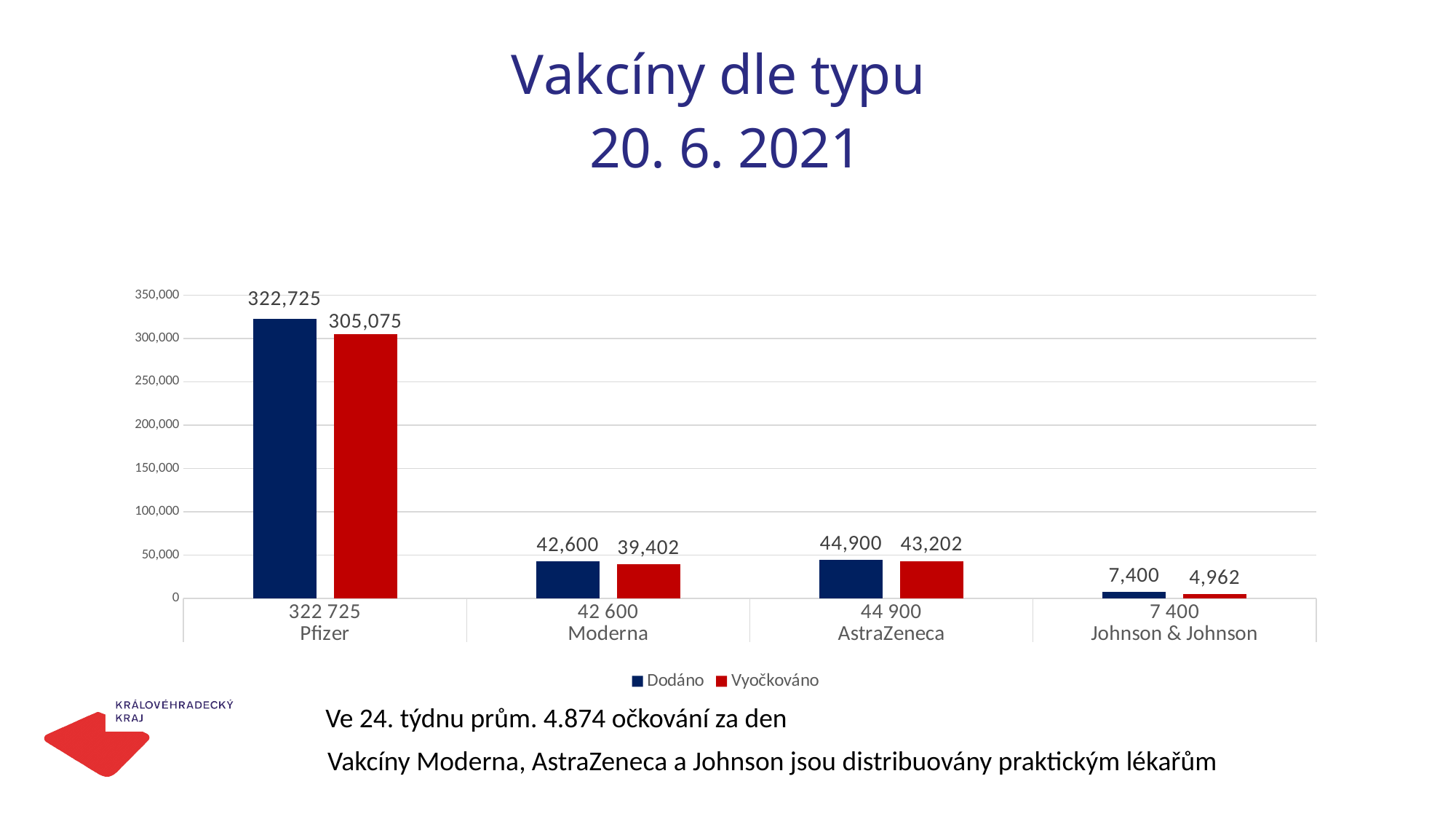
Which vaccine has the lowest Vyočkováno value? Johnson & Johnson What is the difference between the Dodáno and Vyočkováno values for Johnson & Johnson? 2,438 What type of chart is shown on the slide? Bar chart What is the Vyočkováno value for Johnson & Johnson? 4,962 What is the difference between the Dodáno and Vyočkováno values for Pfizer? 17,650 What is the Dodáno value for Pfizer? 322,725 Which vaccine has the highest Dodáno value? Pfizer Which is larger, the Dodáno value for Moderna or the Dodáno value for AstraZeneca? AstraZeneca How many vaccine categories are shown on the x axis? 4 What is the Dodáno value for AstraZeneca? 44,900 What is the Vyočkováno value for Moderna? 39,402 How many series does the legend list? 2